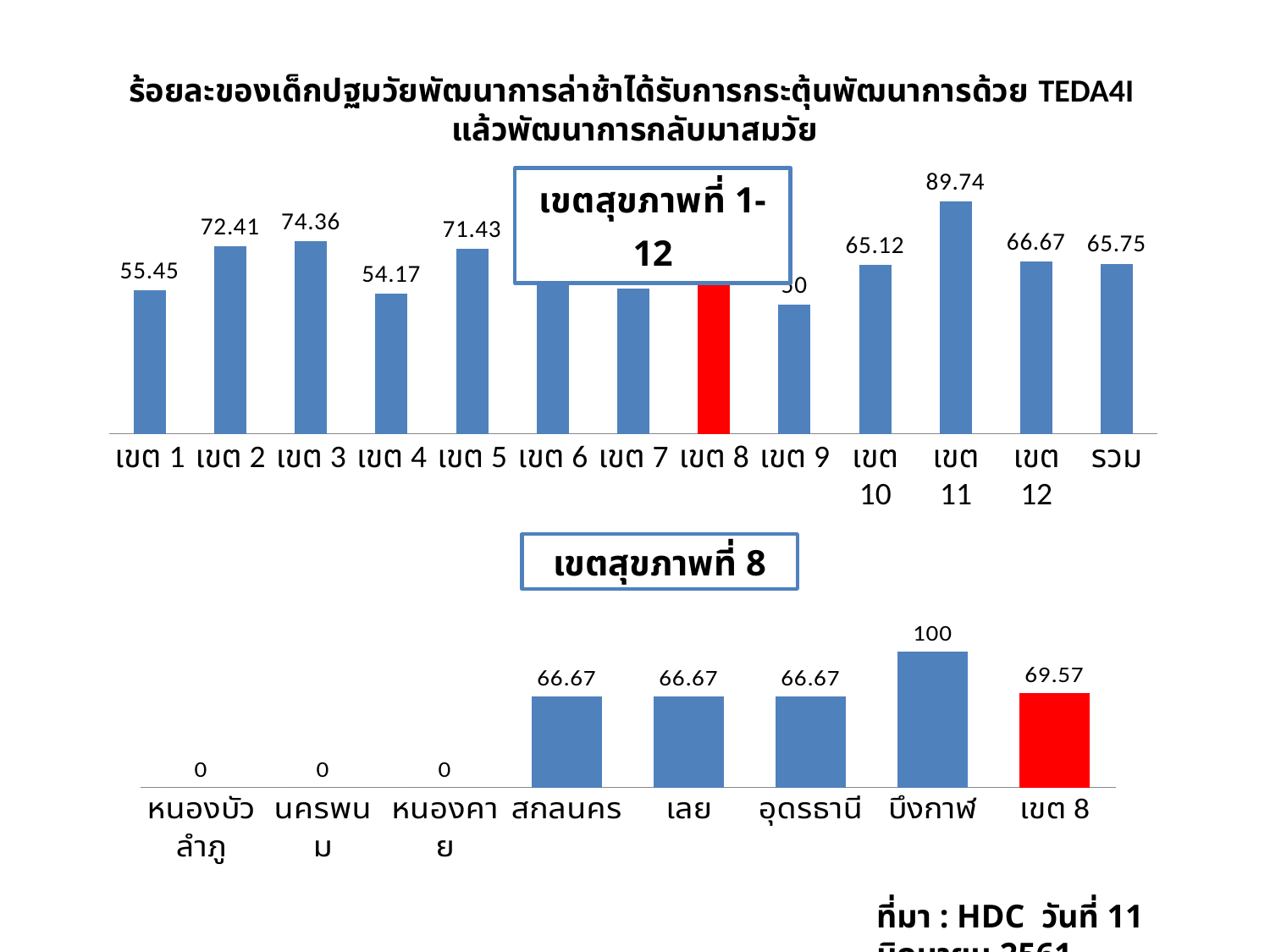
In the top chart (เขตสุขภาพที่ 1-12), which is larger, เขต 3 or เขต 4? เขต 3 In the top chart (เขตสุขภาพที่ 1-12), what is the difference between เขต 11 and เขต 1? 34.29 In the bottom chart (เขตสุขภาพที่ 8), what is the value for บึงกาฬ? 100 In the bottom chart (เขตสุขภาพที่ 8), how many categories are shown on the x axis? 8 In the top chart (เขตสุขภาพที่ 1-12), what is the value for เขต 1? 55.45 In the bottom chart (เขตสุขภาพที่ 8), what is the value for เขต 8? 69.57 In the top chart (เขตสุขภาพที่ 1-12), which category has the highest value? เขต 11 What kind of chart is the bottom chart (เขตสุขภาพที่ 8)? bar chart In the top chart (เขตสุขภาพที่ 1-12), how many categories are shown on the x axis? 13 In the bottom chart (เขตสุขภาพที่ 8), which category has the highest value? บึงกาฬ In the bottom chart (เขตสุขภาพที่ 8), what is the difference between บึงกาฬ and สกลนคร? 33.33 In the top chart (เขตสุขภาพที่ 1-12), what is the value for รวม? 65.75